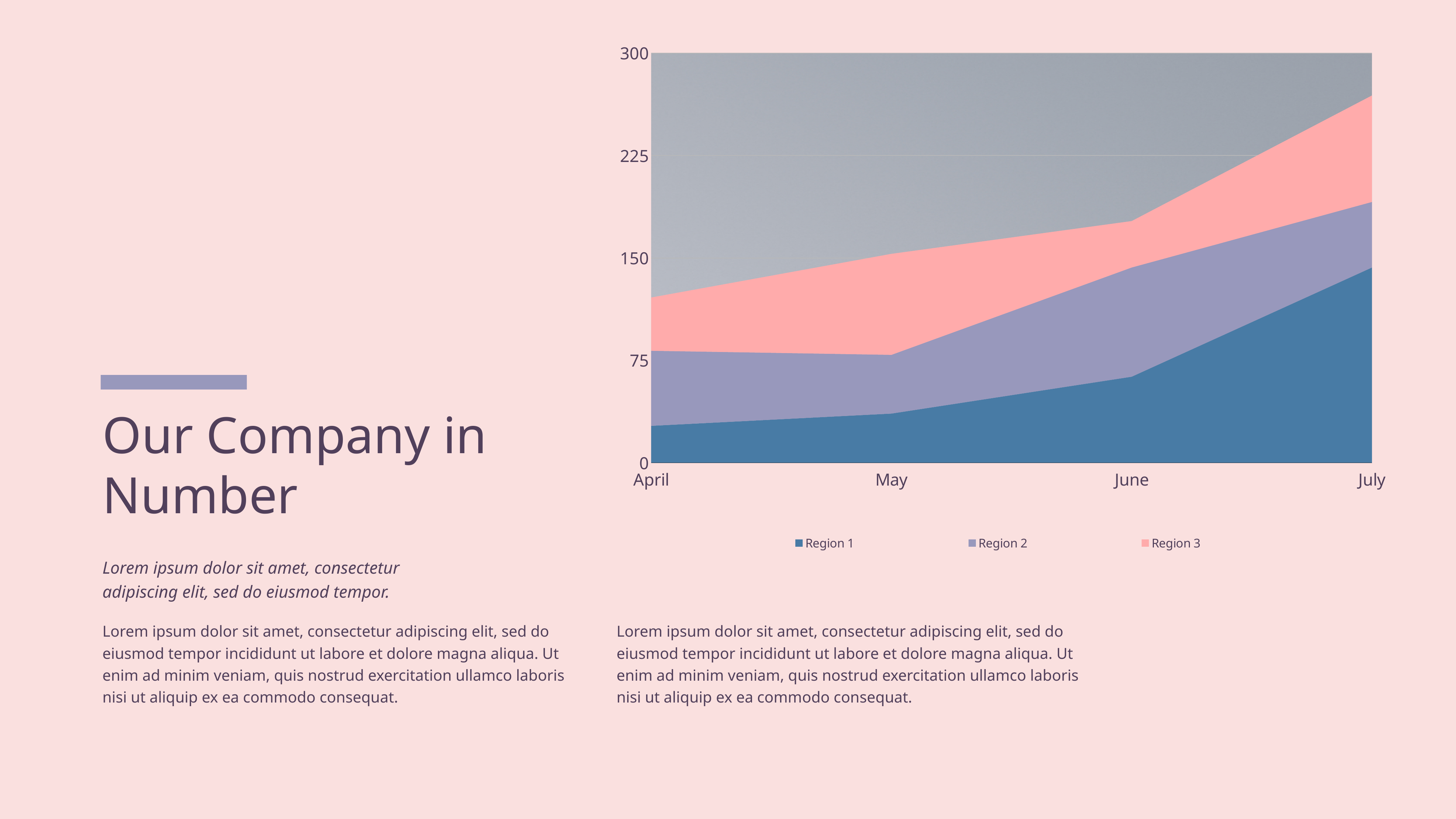
Which month has the highest value for Region 1? July Does the value for Region 1 rise or fall from April to July? Rise Is the stacked total of all three regions in April greater or less than 150? less Is the stacked total of all three regions in July greater or less than 225? greater Which month has the lowest value for Region 1? April Is the value for Region 1 in June greater or less than 75? less Is the value for Region 1 larger in April or in July? July How many series does the chart's legend list? 3 Which series are listed in the chart's legend? Region 1, Region 2, Region 3 How many months are shown along the x axis of the chart? 4 What kind of chart is shown on the slide? Area chart